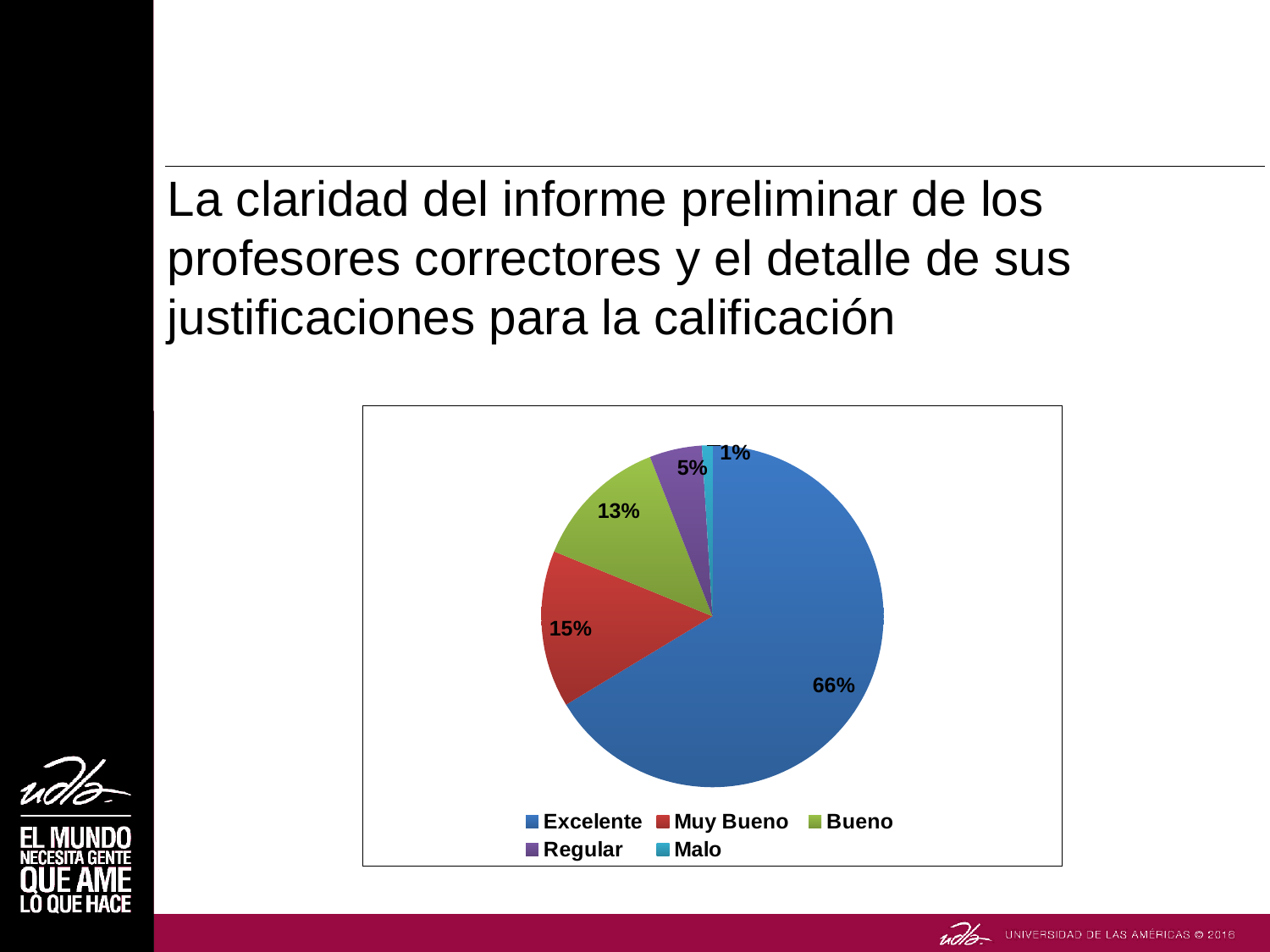
What percentage of the pie chart is labelled Muy Bueno? 15% What type of chart is shown on the slide? Pie chart How many categories does the pie chart show? 5 What percentage of the pie chart is labelled Bueno? 13% What colour is the Bueno slice in the pie chart? Green What percentage of the pie chart is labelled Malo? 1% What percentage of the pie chart is labelled Regular? 5% Which category has the smallest slice of the pie chart? Malo What percentage of the pie chart is labelled Excelente? 66% What is the difference in percentage points between the Excelente and Muy Bueno slices? 51 Which category has the largest slice of the pie chart? Excelente Which slice is larger, Muy Bueno or Bueno? Muy Bueno